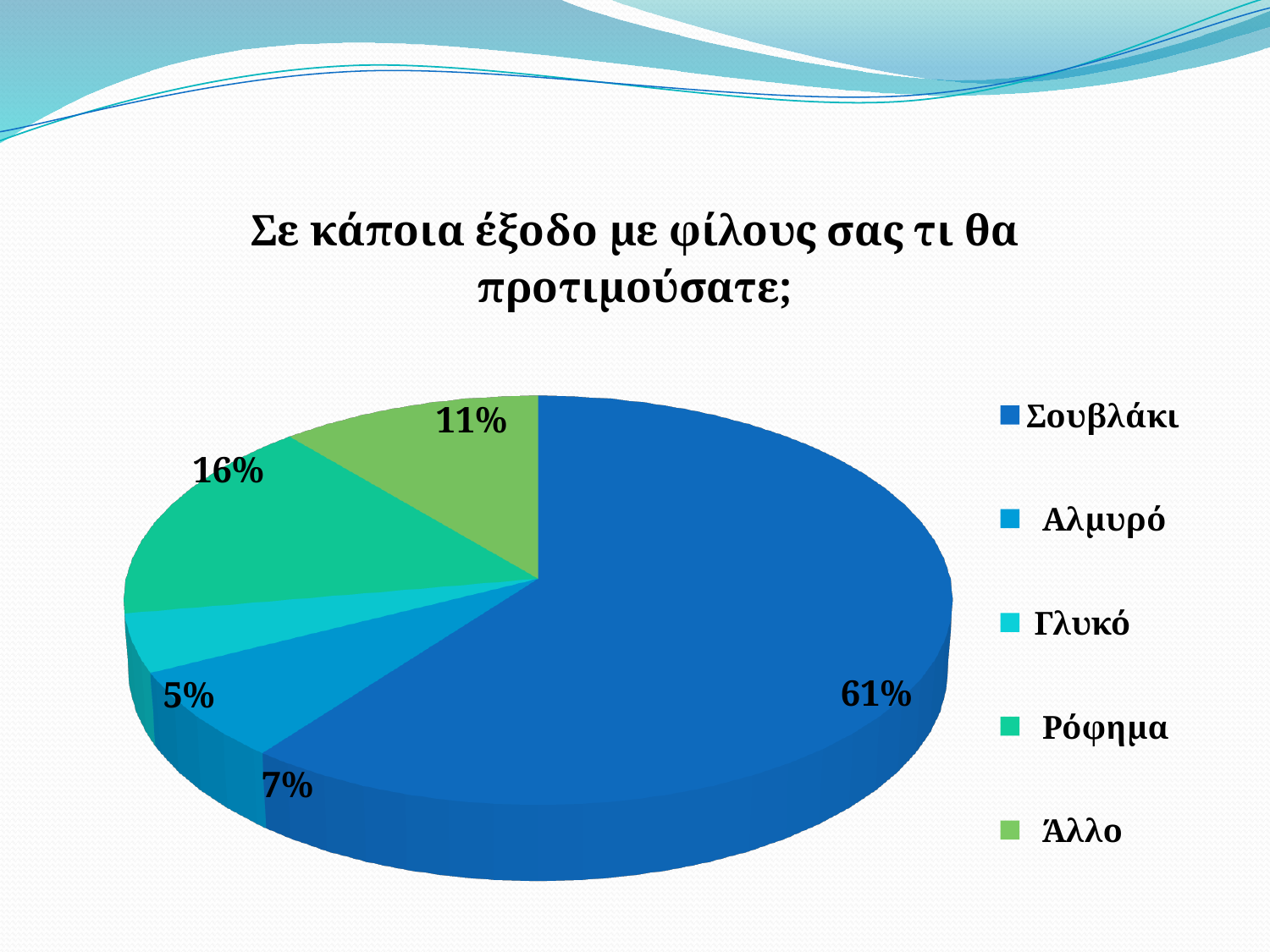
What is the title of the chart? Σε κάποια έξοδο με φίλους σας τι θα προτιμούσατε; Which category has the largest share of the pie? Σουβλάκι Which is larger, the share for Αλμυρό or the share for Άλλο? Άλλο What percentage of respondents chose Άλλο? 11% What percentage of respondents chose Ρόφημα? 16% What percentage of respondents chose Σουβλάκι? 61% What percentage of respondents chose Γλυκό? 5% What is the combined share of Αλμυρό and Γλυκό? 12% Which category has the smallest share of the pie? Γλυκό What type of chart is shown on the slide? pie chart What is the difference in percentage points between Σουβλάκι and Ρόφημα? 45 How many categories does the legend list? 5